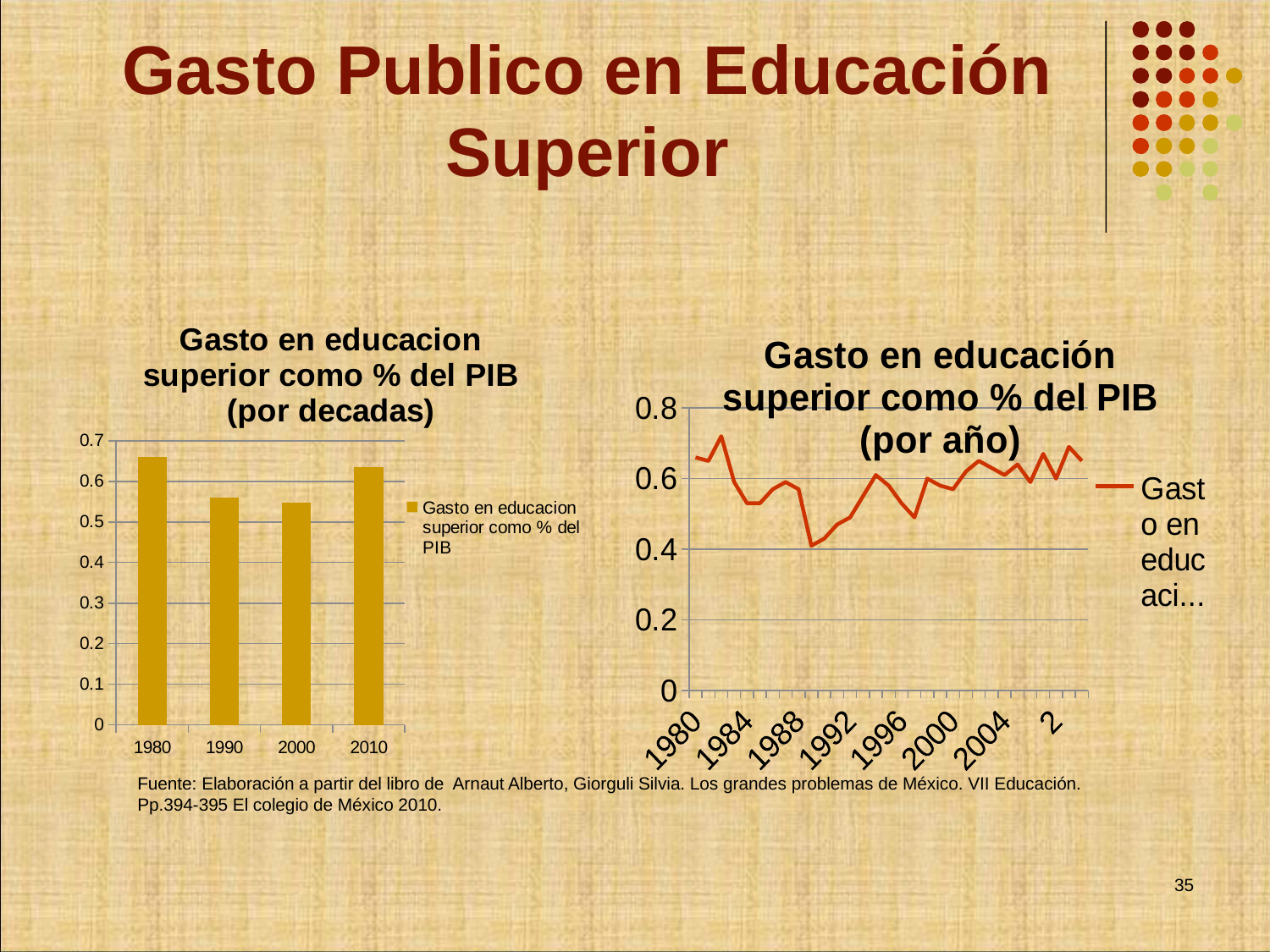
In the left chart (por decadas), which decade has the highest value? 1980 In the left chart (por decadas), how many decades are shown on the x axis? 4 In the left chart (por decadas), which is larger, the value for 1980 or the value for 1990? 1980 In the left chart (por decadas), how many series does the legend list? 1 In the left chart (por decadas), is the value for 2010 greater or less than 0.6? greater In the left chart (por decadas), is the value for 1990 greater or less than 0.6? less In the right chart (por año), is the value for 1990 greater or less than 0.5? less What kind of chart is the left chart titled 'Gasto en educacion superior como % del PIB (por decadas)'? bar chart What kind of chart is the right chart titled 'Gasto en educación superior como % del PIB (por año)'? line chart In the left chart (por decadas), what is the legend entry for the bars? Gasto en educacion superior como % del PIB In the right chart (por año), do the values rise or fall between 1980 and 1990? fall